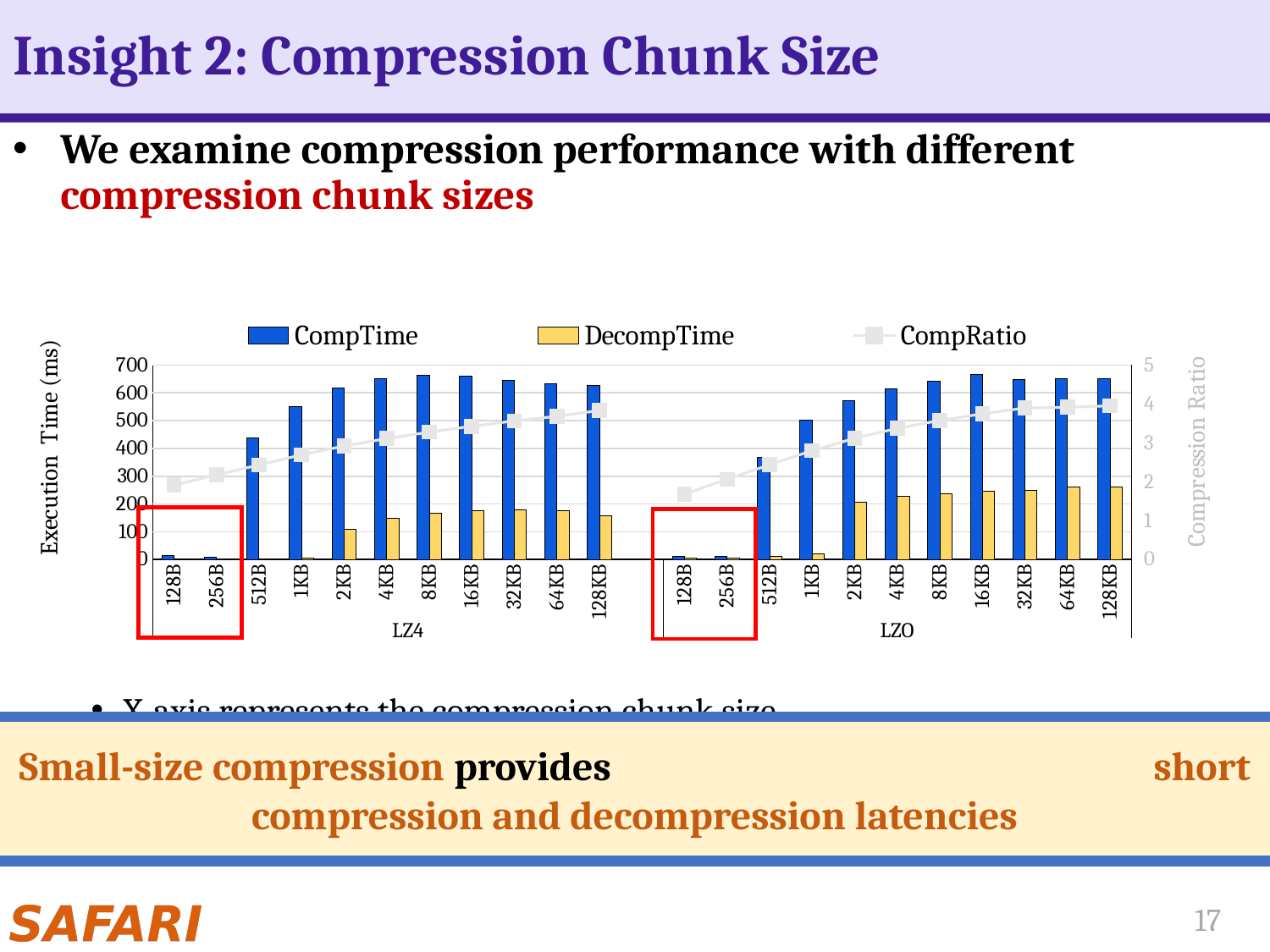
Is the DecompTime value for LZ4 at 2KB greater or less than 200? less How many chunk-size categories are plotted for the LZ4 group? 11 What is the title of the left vertical axis? Execution Time (ms) Which has the larger CompTime in the LZ4 group, 512B or 8KB? 8KB Is the CompTime value for LZ4 at 512B greater or less than 500? less Is the CompRatio value for LZO at 128B greater or less than 2? less What kind of chart is shown on the slide? Bar chart with a line series How many series does the chart legend list? 3 What are the three series named in the chart legend? CompTime, DecompTime, CompRatio Does the CompRatio line rise or fall as the chunk size increases within the LZO group? rises